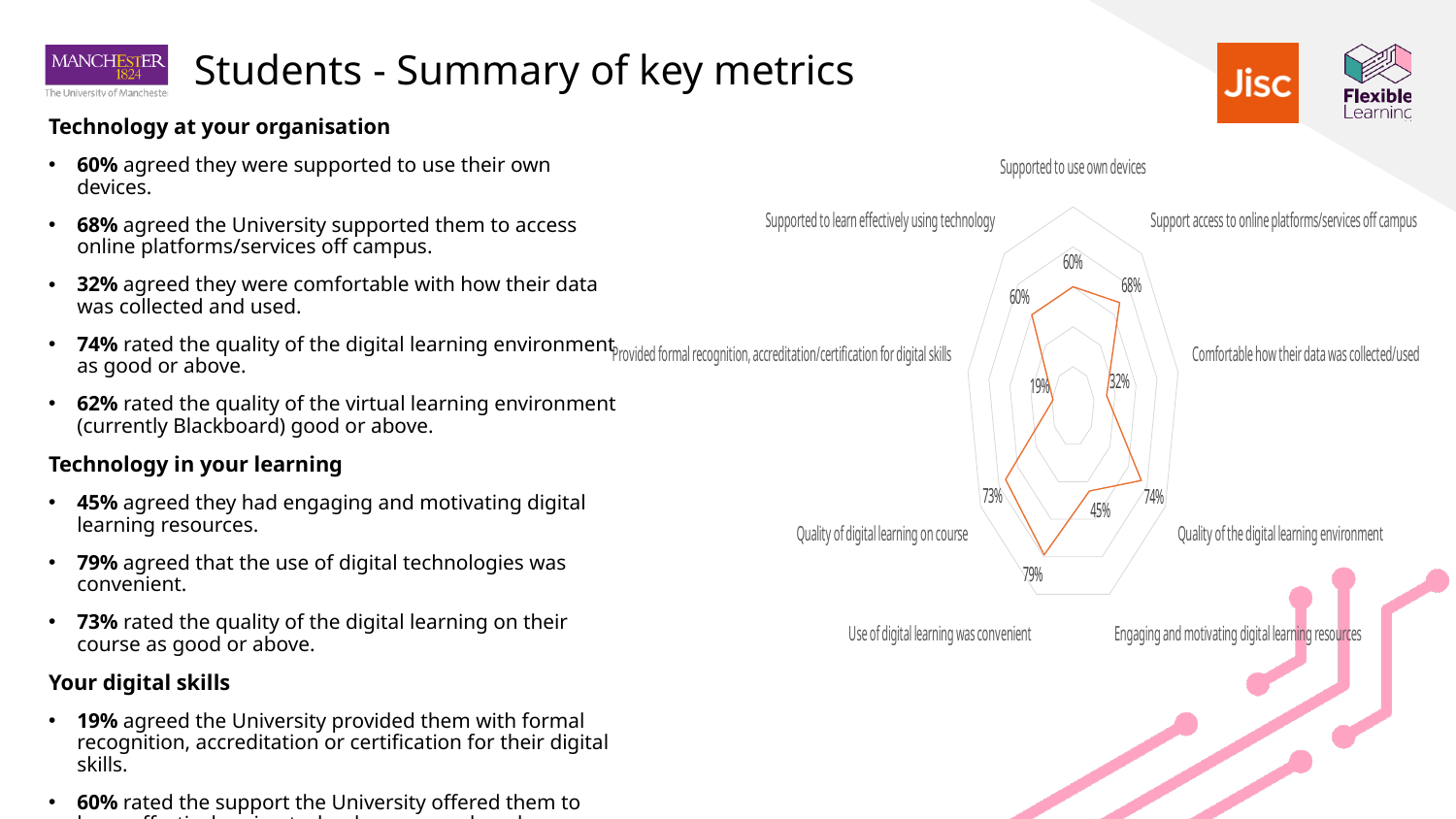
Which category has the lowest value on the radar chart? Provided formal recognition, accreditation/certification for digital skills What kind of chart is shown on the slide? radar chart What is the value for 'Use of digital learning was convenient'? 79% What is the value for 'Supported to use own devices'? 60% What colour is the data line on the radar chart? orange Which is larger: 'Support access to online platforms/services off campus' or 'Supported to use own devices'? Support access to online platforms/services off campus Which category has the highest value on the radar chart? Use of digital learning was convenient What is the difference between 'Use of digital learning was convenient' and 'Quality of digital learning on course'? 6% How many categories does the radar chart have? 9 What is the value for 'Provided formal recognition, accreditation/certification for digital skills'? 19% What is the value for 'Comfortable how their data was collected/used'? 32% What is the difference between 'Quality of the digital learning environment' and 'Engaging and motivating digital learning resources'? 29%